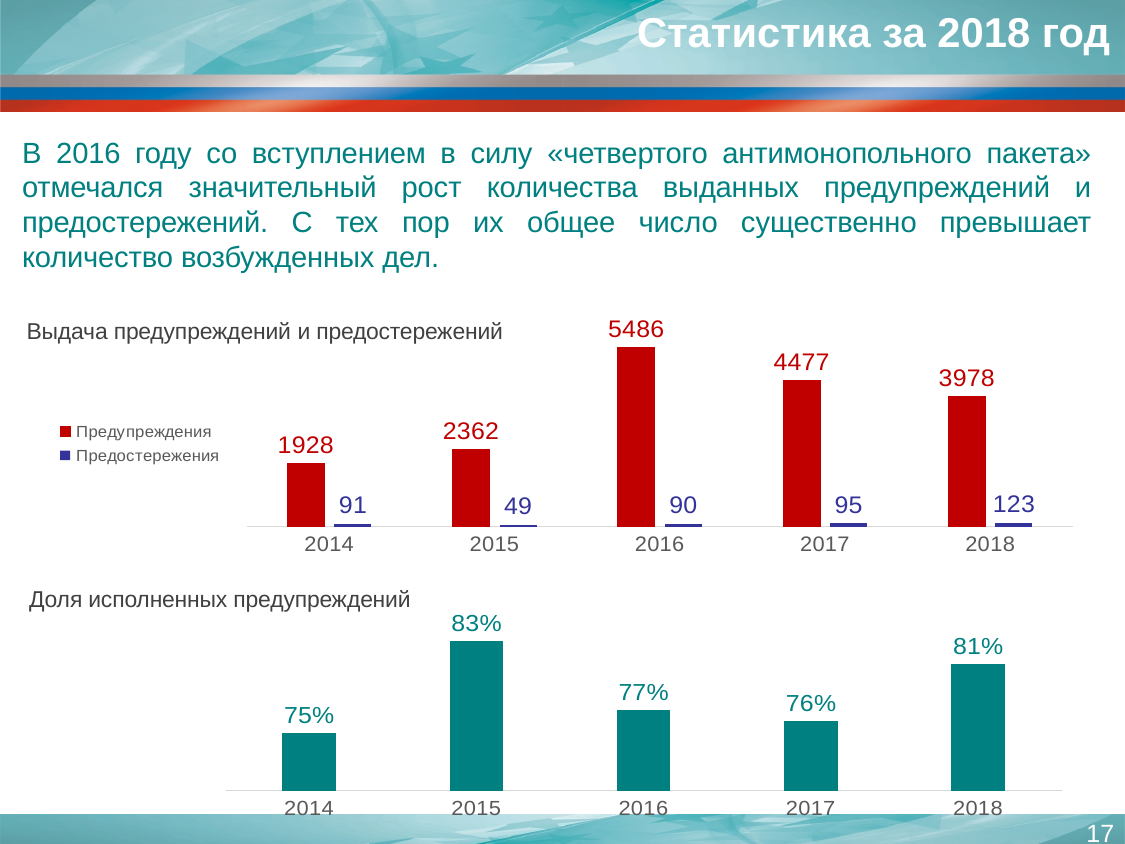
In the chart 'Доля исполненных предупреждений', which is larger, the value for 2016 or the value for 2018? 2018 What kind of chart is 'Доля исполненных предупреждений'? bar chart In the chart 'Доля исполненных предупреждений', how many years are shown? 5 In the chart 'Доля исполненных предупреждений', which year has the lowest value? 2014 In the chart 'Выдача предупреждений и предостережений', what is the value of Предупреждения for 2016? 5486 In the chart 'Доля исполненных предупреждений', what is the value for 2015? 83% In the chart 'Выдача предупреждений и предостережений', how many series does the legend list? 2 In the chart 'Выдача предупреждений и предостережений', what is the difference between Предупреждения in 2016 and 2017? 1009 In the chart 'Выдача предупреждений и предостережений', what is the value of Предостережения for 2018? 123 In the chart 'Выдача предупреждений и предостережений', which series is shown in red? Предупреждения In the chart 'Выдача предупреждений и предостережений', which year has the lowest value of Предостережения? 2015 In the chart 'Выдача предупреждений и предостережений', which year has the highest value of Предупреждения? 2016